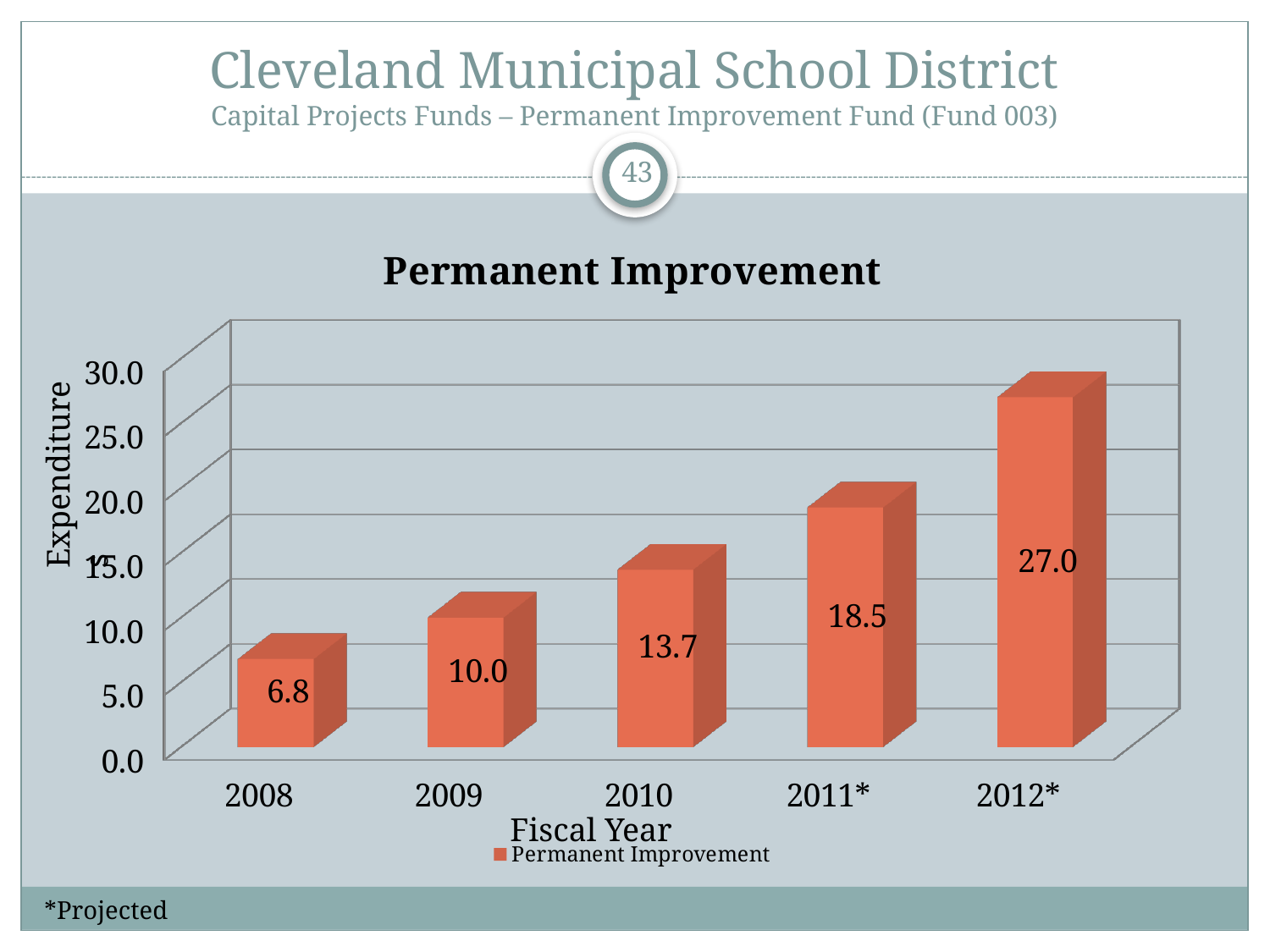
What is the difference between the expenditure for 2009 and the expenditure for 2008? 3.2 What is the Permanent Improvement expenditure for fiscal year 2012*? 27.0 How many fiscal years are shown on the x axis of the chart? 5 What kind of chart is shown on the slide? Bar chart Which fiscal year has a larger expenditure, 2010 or 2011*? 2011* What is the Permanent Improvement expenditure for fiscal year 2010? 13.7 What is the Permanent Improvement expenditure for fiscal year 2008? 6.8 Which fiscal year has the highest Permanent Improvement expenditure? 2012* Do the expenditure values rise or fall from 2008 to 2012*? Rise What is the difference between the expenditure for 2012* and the expenditure for 2011*? 8.5 How many series does the chart legend list? 1 Which fiscal year has the lowest Permanent Improvement expenditure? 2008